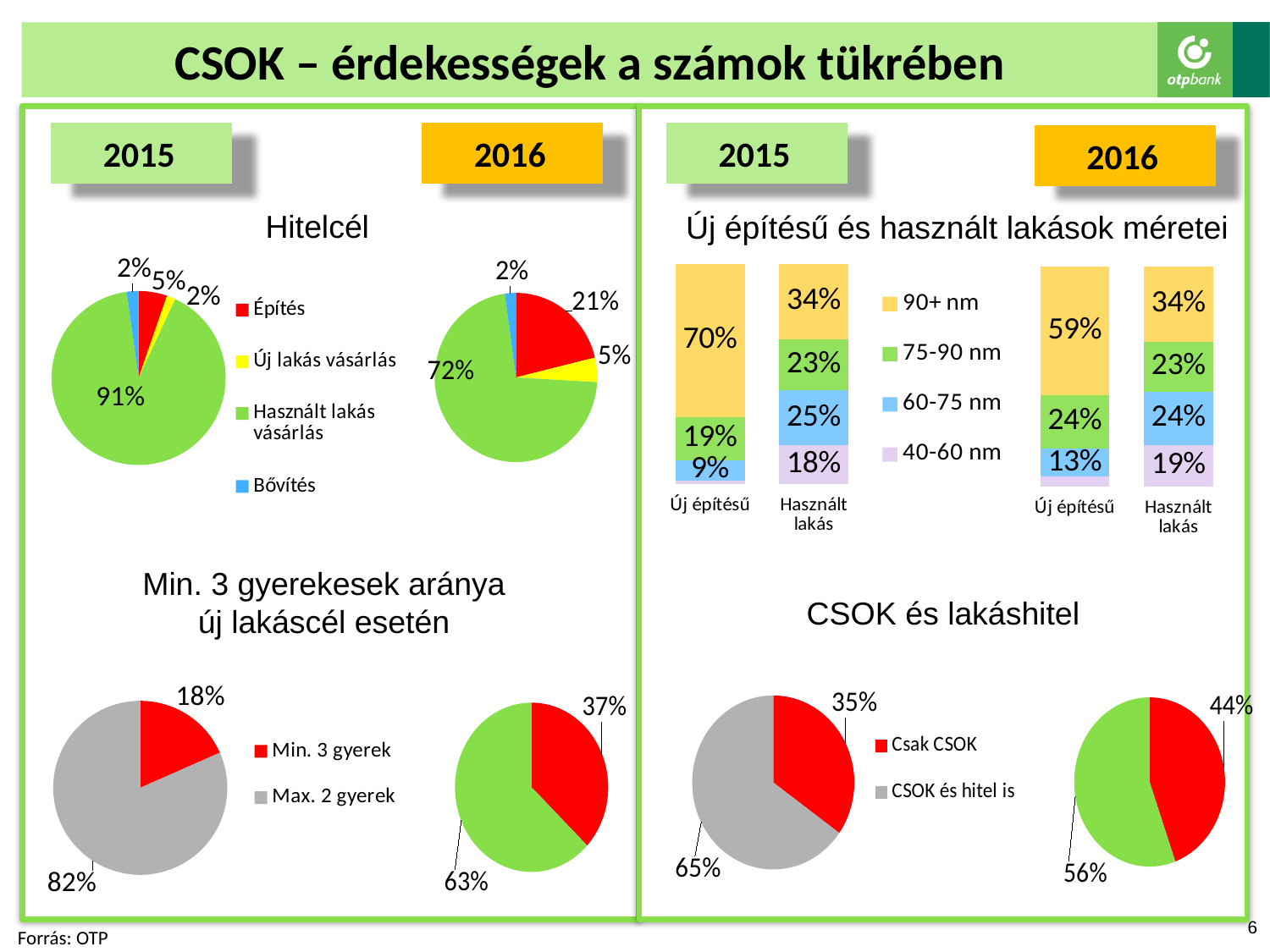
In the 2016 'CSOK és lakáshitel' pie chart, what is the difference between the 'CSOK és hitel is' share and the 'Csak CSOK' share? 12 percentage points In the 'Új építésű és használt lakások méretei' charts, what is the difference between the '90+ nm' share of 'Új építésű' in 2015 and in 2016? 11 percentage points In the 2015 'CSOK és lakáshitel' pie chart, what share is 'Csak CSOK'? 35% In the 2016 'Min. 3 gyerekesek aránya új lakáscél esetén' pie chart, which is larger: 'Min. 3 gyerek' or 'Max. 2 gyerek'? Max. 2 gyerek How many categories does the legend of the 'Hitelcél' pie charts list? 4 In the 2015 'Min. 3 gyerekesek aránya új lakáscél esetén' pie chart, what share is 'Min. 3 gyerek'? 18% In the 2016 'Új építésű és használt lakások méretei' chart, what is the value for '60-75 nm' in the 'Használt lakás' bar? 24% In the 2015 'Új építésű és használt lakások méretei' chart, what is the value for '90+ nm' in the 'Új építésű' bar? 70% In the 2016 'Hitelcél' pie chart, what share is 'Építés'? 21% What type of chart is 'Új építésű és használt lakások méretei'? Stacked bar chart In the 2016 'Hitelcél' pie chart, which category has the largest share? Használt lakás vásárlás In the 2015 'Hitelcél' pie chart, what share is 'Használt lakás vásárlás'? 91%